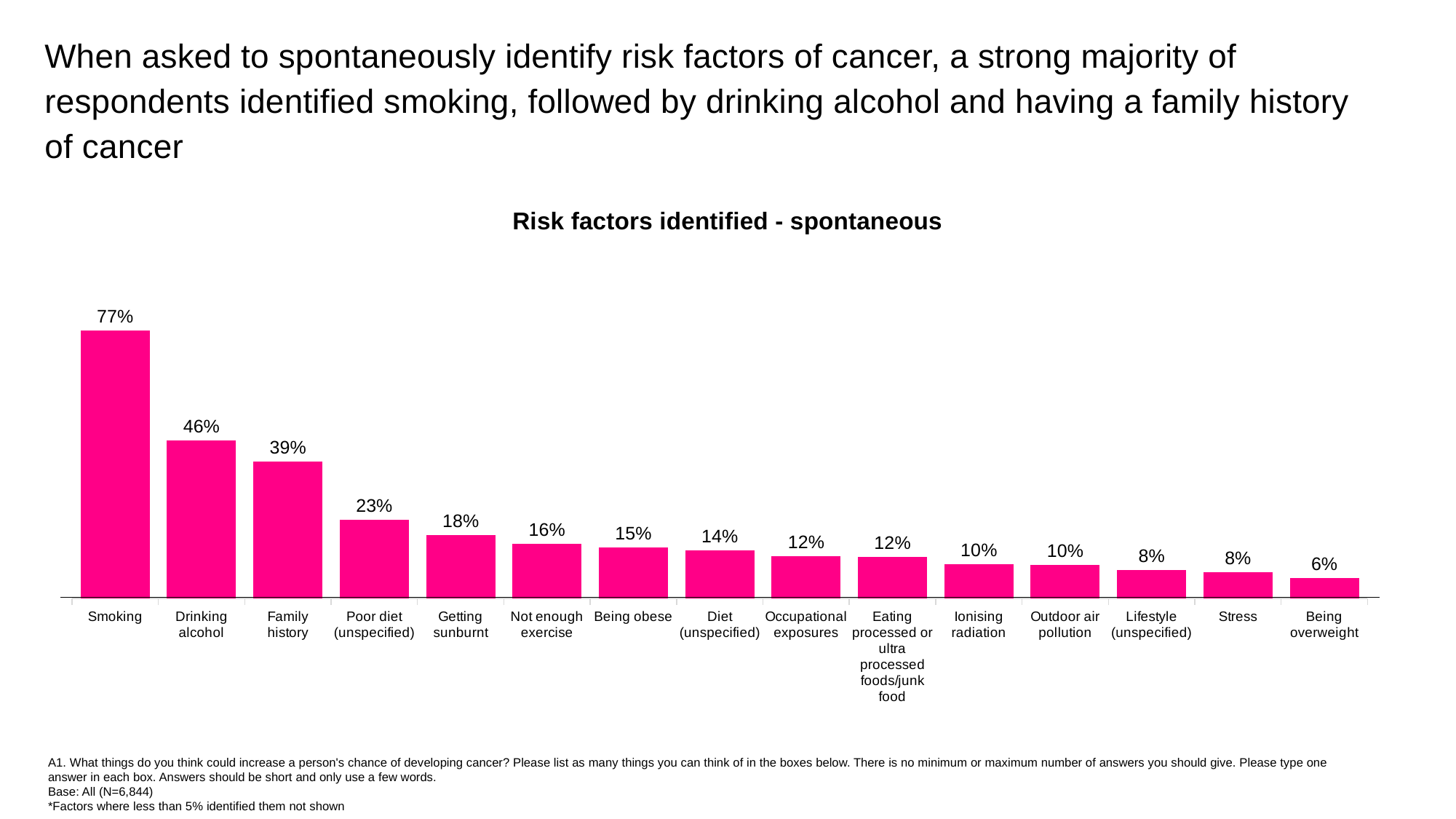
What is the difference between the values for Family history and Poor diet (unspecified)? 16% What kind of chart is shown on the slide? Bar chart What is the title of the chart? Risk factors identified - spontaneous What percentage of respondents identified smoking as a risk factor? 77% What is the difference between the values for Smoking and Drinking alcohol? 31% Which risk factor has the lowest value? Being overweight What is the value for Ionising radiation? 10% Which risk factor has the highest value? Smoking Do the values rise or fall from left to right across the chart? Fall Which is larger, the value for Not enough exercise or the value for Stress? Not enough exercise What is the value for Getting sunburnt? 18% How many risk factors are shown in the chart? 15